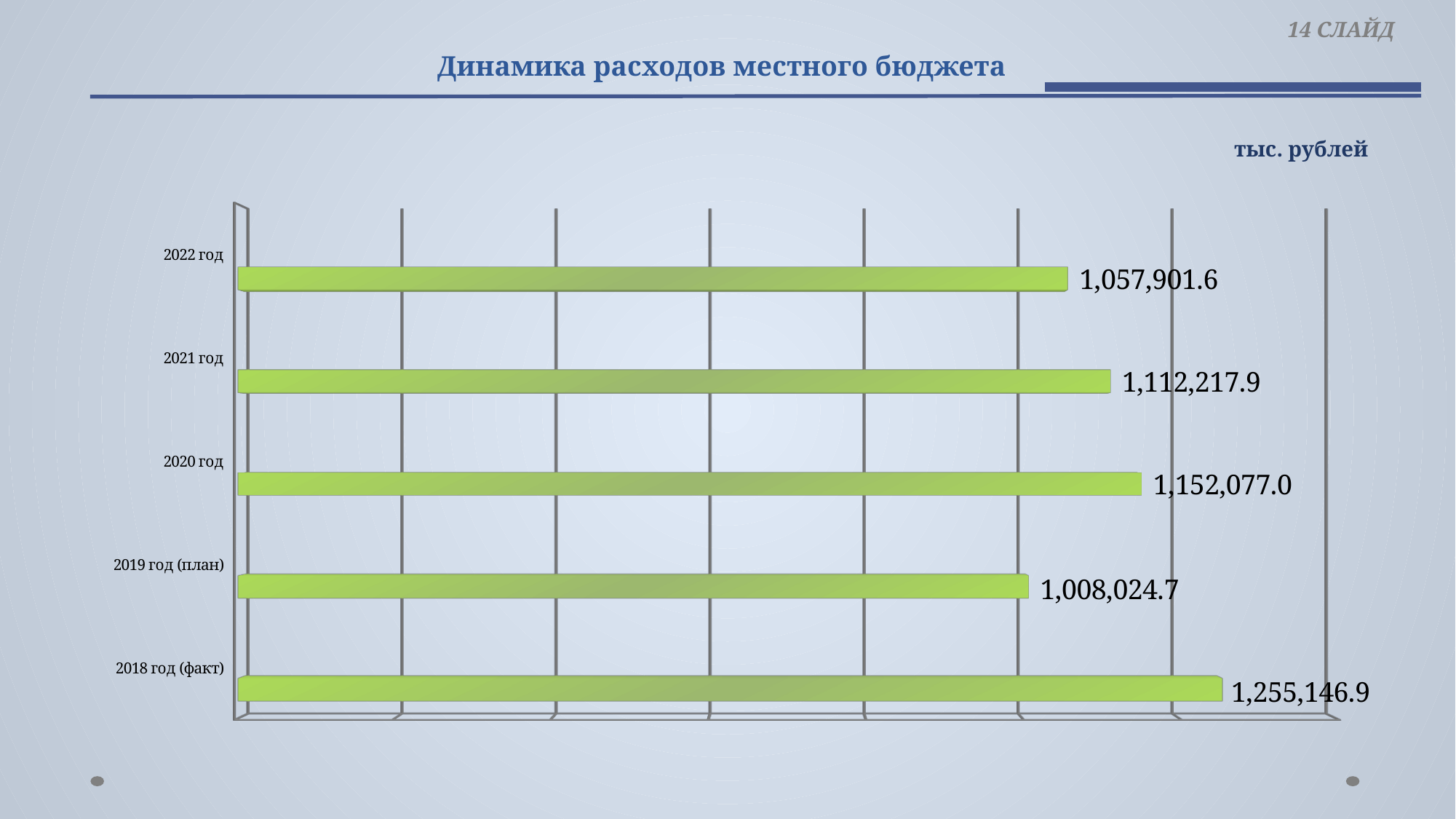
What is the difference between the values for 2018 год (факт) and 2019 год (план)? 247,122.2 What is the value for 2019 год (план)? 1,008,024.7 From 2020 год to 2022 год, do the values rise or fall? fall What unit is stated for the values in the chart? тыс. рублей How many categories are shown in the chart? 5 What is the value for 2018 год (факт)? 1,255,146.9 Which is larger, the value for 2021 год or the value for 2022 год? 2021 год What is the value for 2022 год? 1,057,901.6 Which category has the highest value? 2018 год (факт) Which category has the lowest value? 2019 год (план) What is the difference between the values for 2020 год and 2021 год? 39,859.1 What kind of chart is shown on the slide? bar chart